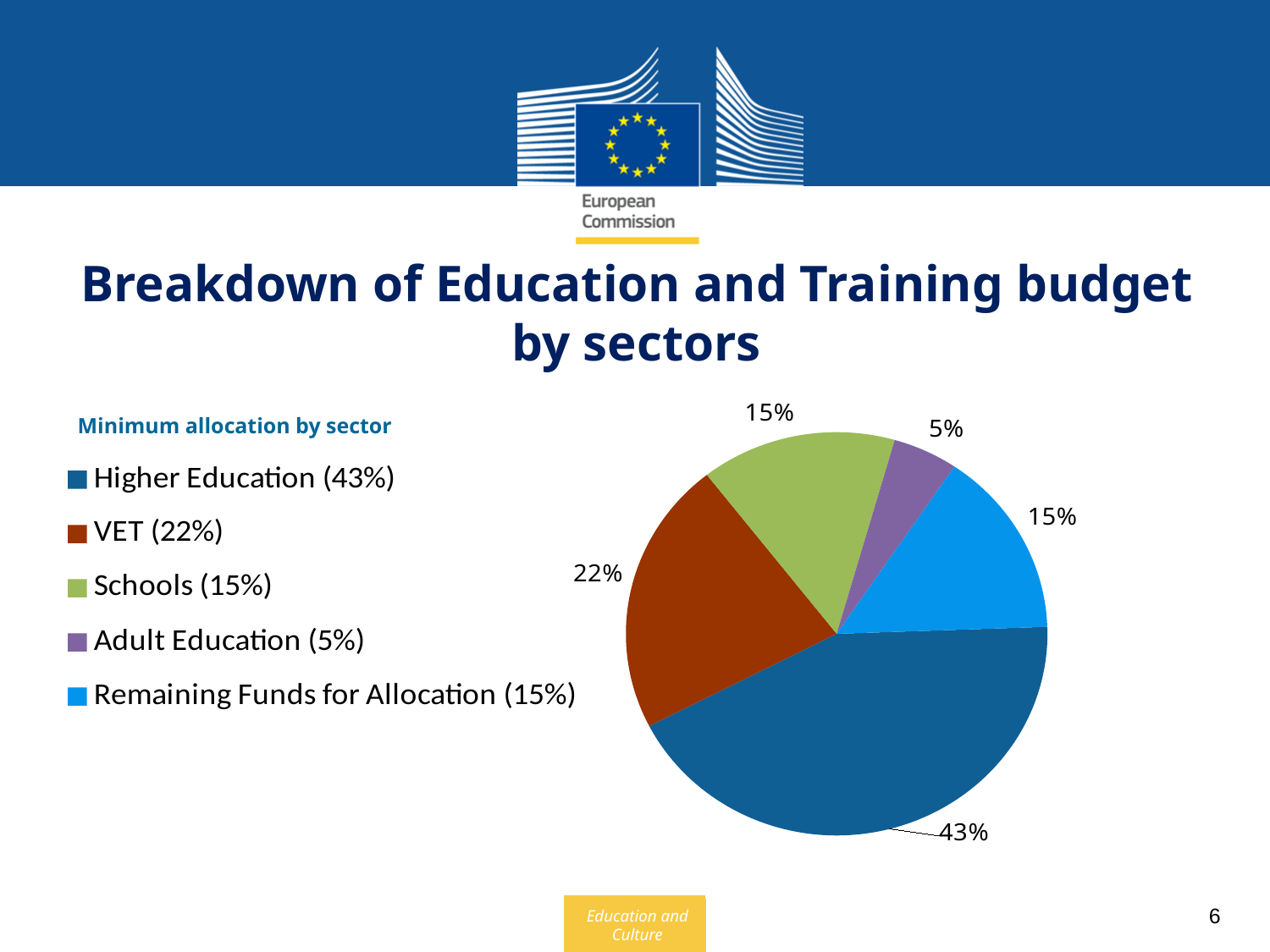
How many sectors are shown in the pie chart? 5 Which sector has the smallest share of the budget? Adult Education What is the title of the legend above the sector list? Minimum allocation by sector What share of the budget is allocated to Schools? 15% What is the combined share of Schools and Remaining Funds for Allocation? 30% Which is larger, the share for VET or the share for Schools? VET What share of the budget is allocated to Higher Education? 43% What is the difference between the Higher Education share and the VET share? 21% What share of the budget is allocated to Adult Education? 5% What share of the budget is allocated to VET? 22% What kind of chart is shown on the slide? pie chart Which sector has the largest share of the budget? Higher Education